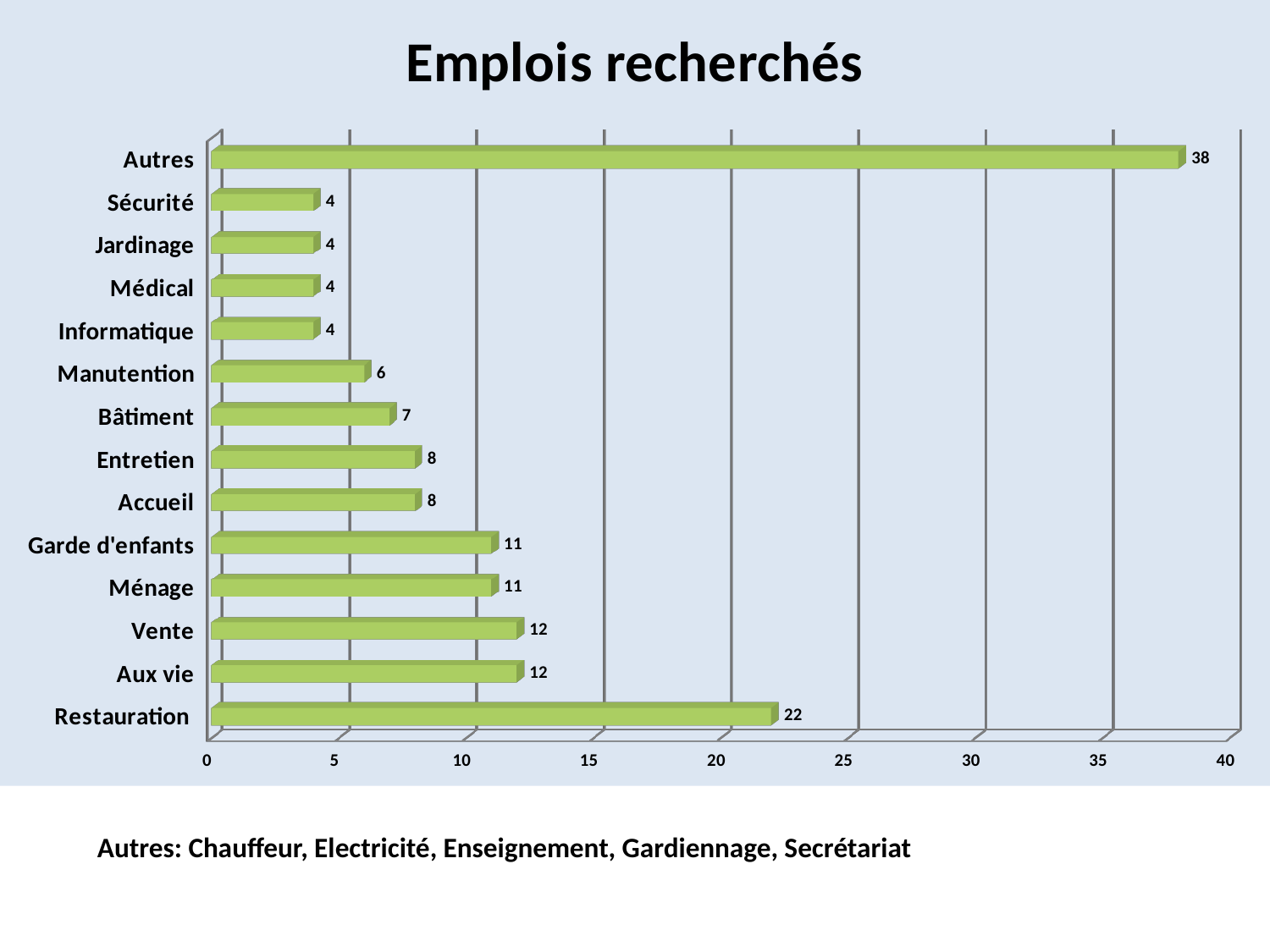
How many categories are shown in the chart? 14 What is the title of the chart? Emplois recherchés What is the difference between the values for Autres and Restauration? 16 What is the value for Restauration? 22 Is the value for Restauration greater or less than 20? greater What is the value for Garde d'enfants? 11 Which category has the highest value? Autres What is the difference between the values for Vente and Bâtiment? 5 What is the value for Manutention? 6 How many categories have a value of 4? 4 What kind of chart is shown on the slide? Bar chart Which is larger, the value for Entretien or the value for Ménage? Ménage